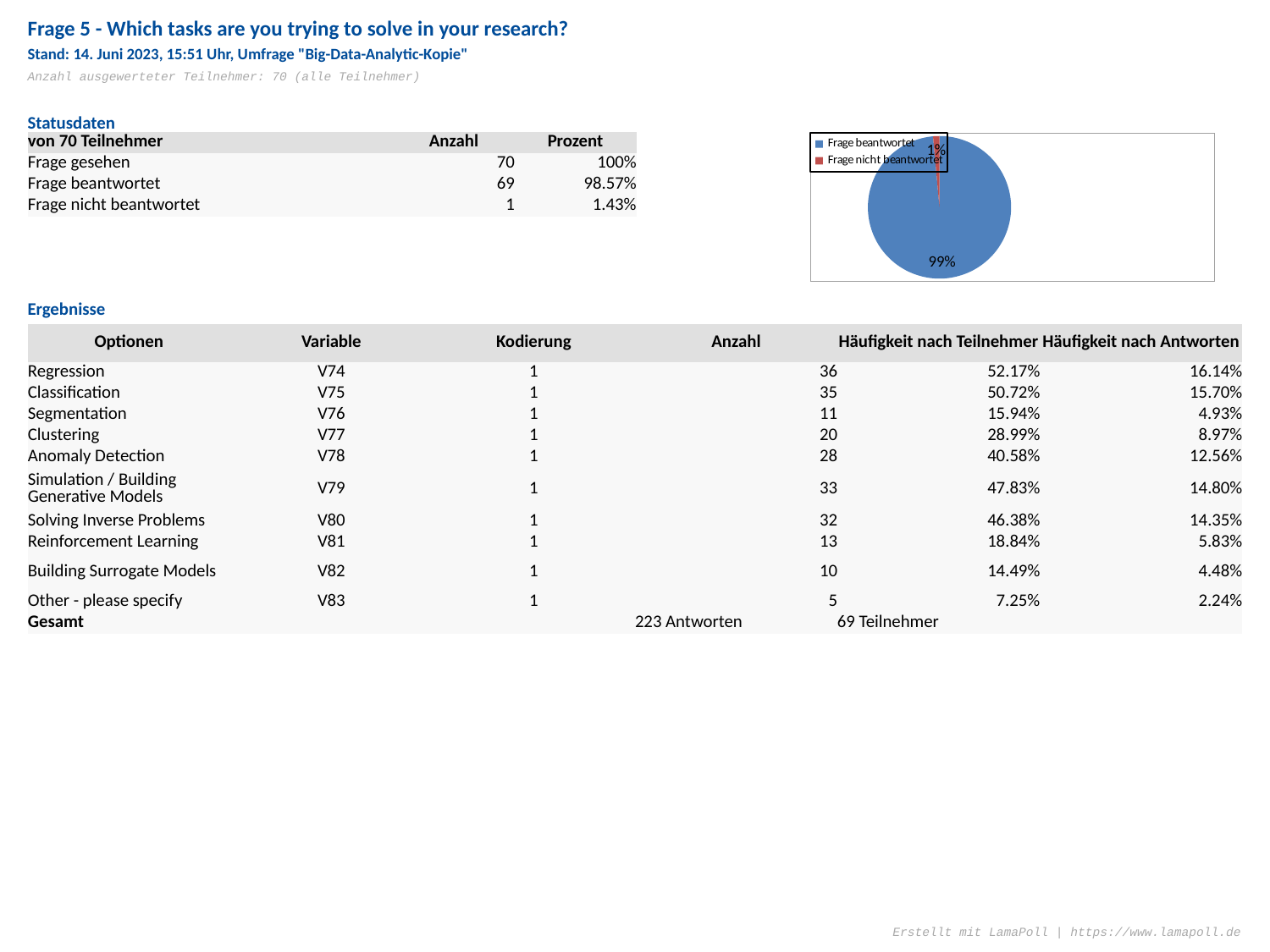
What kind of chart is shown on the slide? pie chart What share of the pie chart is labelled for "Frage beantwortet"? 99% How many slices does the pie chart have? 2 What share of the pie chart is labelled for "Frage nicht beantwortet"? 1% How many entries does the legend of the pie chart list? 2 What colour is the "Frage beantwortet" slice in the pie chart? blue Which slice of the pie chart is the largest? Frage beantwortet What is the first entry listed in the pie chart's legend? Frage beantwortet In the pie chart, which is larger: "Frage beantwortet" or "Frage nicht beantwortet"? Frage beantwortet What is the difference in percentage points between the two slices of the pie chart? 98 Which slice of the pie chart is the smallest? Frage nicht beantwortet